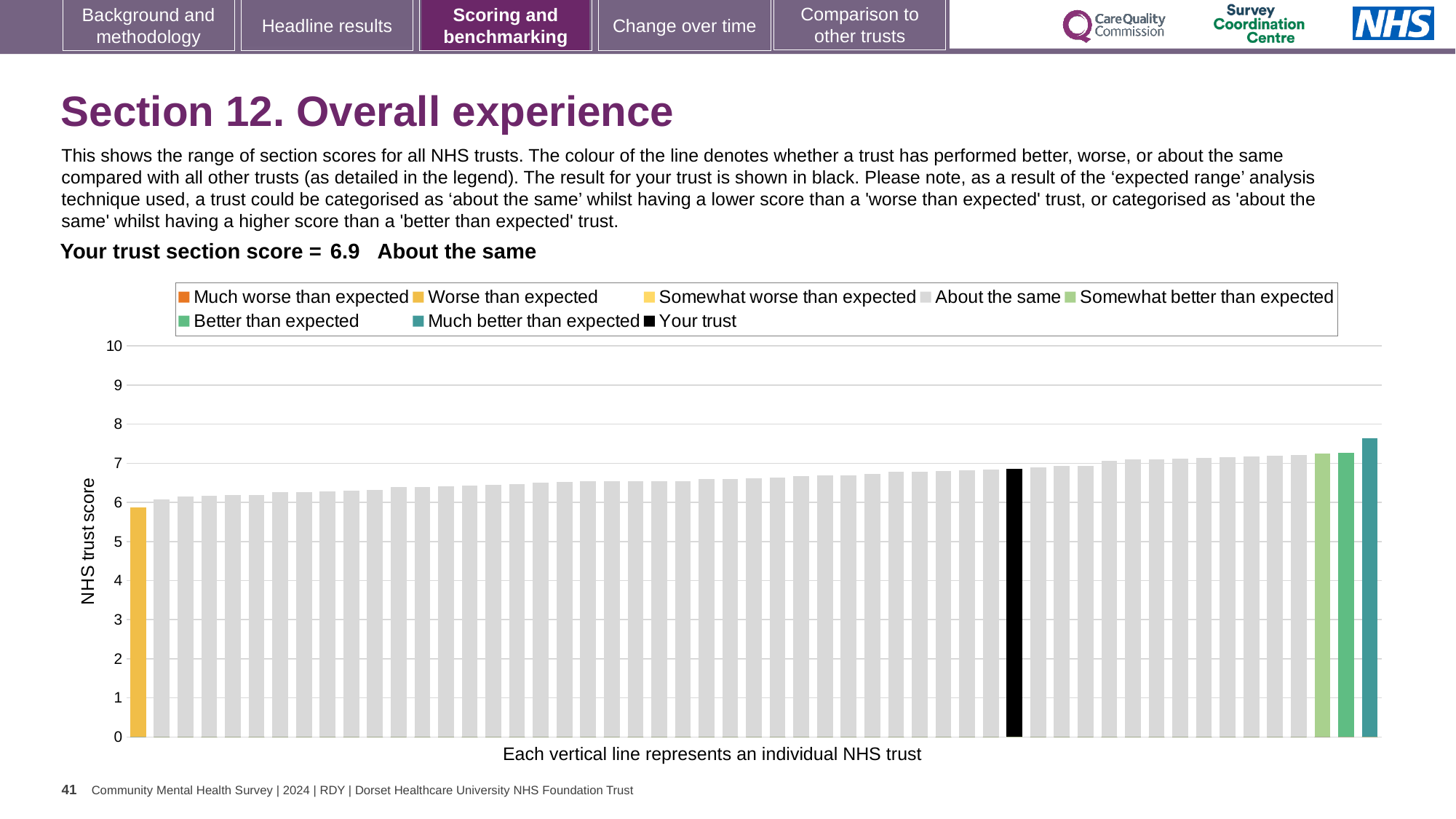
Which legend category does the shortest bar belong to? Worse than expected Which is larger, the rightmost bar or the leftmost bar? the rightmost bar Is the value of the leftmost (yellow) bar greater or less than 6? less What is the trust's section score shown on the slide? 6.9 Which legend category does the tallest bar belong to? Much better than expected Is the value of the rightmost (teal) bar greater or less than 7? greater How many entries does the chart legend list? 8 What kind of chart is shown on the slide? bar chart What colour is the bar representing 'Your trust'? black According to the x-axis caption, what does each vertical line represent? an individual NHS trust Is the value of the black 'Your trust' bar greater or less than 7? less Do the bar values rise or fall from left to right along the x axis? rise